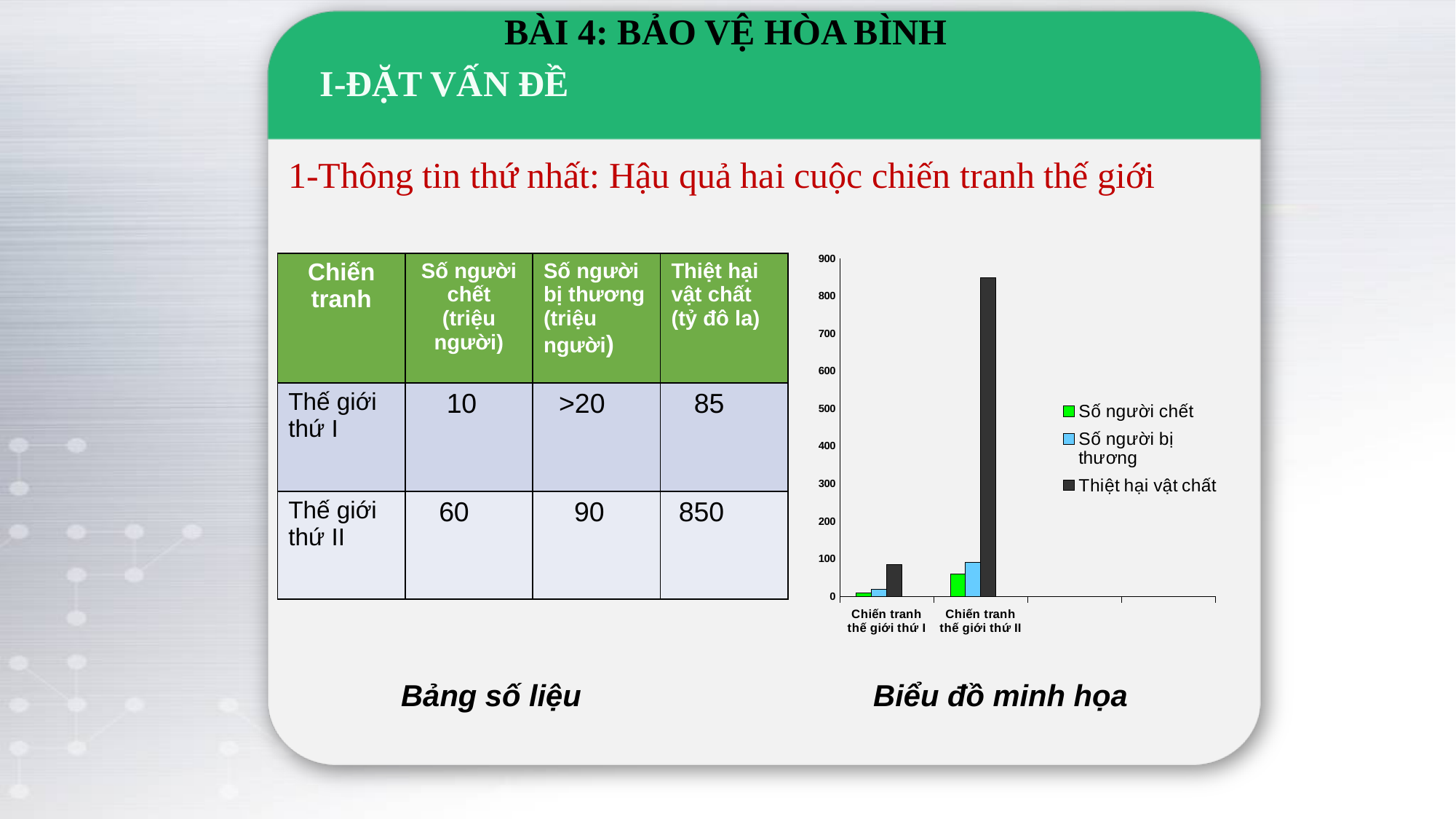
What kind of chart is shown on the right of the slide? bar chart Which series has the shortest bar for Chiến tranh thế giới thứ I? Số người chết How many series does the chart's legend list? 3 Which category has the larger value for Số người chết, Chiến tranh thế giới thứ I or Chiến tranh thế giới thứ II? Chiến tranh thế giới thứ II Which series has the tallest bar for Chiến tranh thế giới thứ II? Thiệt hại vật chất How many categories are shown on the x axis of the chart? 2 What colour represents the series Số người chết in the chart? green Which category has the larger value for Thiệt hại vật chất, Chiến tranh thế giới thứ I or Chiến tranh thế giới thứ II? Chiến tranh thế giới thứ II Do the values for Thiệt hại vật chất rise or fall from Chiến tranh thế giới thứ I to Chiến tranh thế giới thứ II? rise Is the value for Số người bị thương in Chiến tranh thế giới thứ II greater or less than 100? less Is the value for Thiệt hại vật chất in Chiến tranh thế giới thứ II greater or less than 800? greater Is the value for Thiệt hại vật chất in Chiến tranh thế giới thứ I greater or less than 100? less